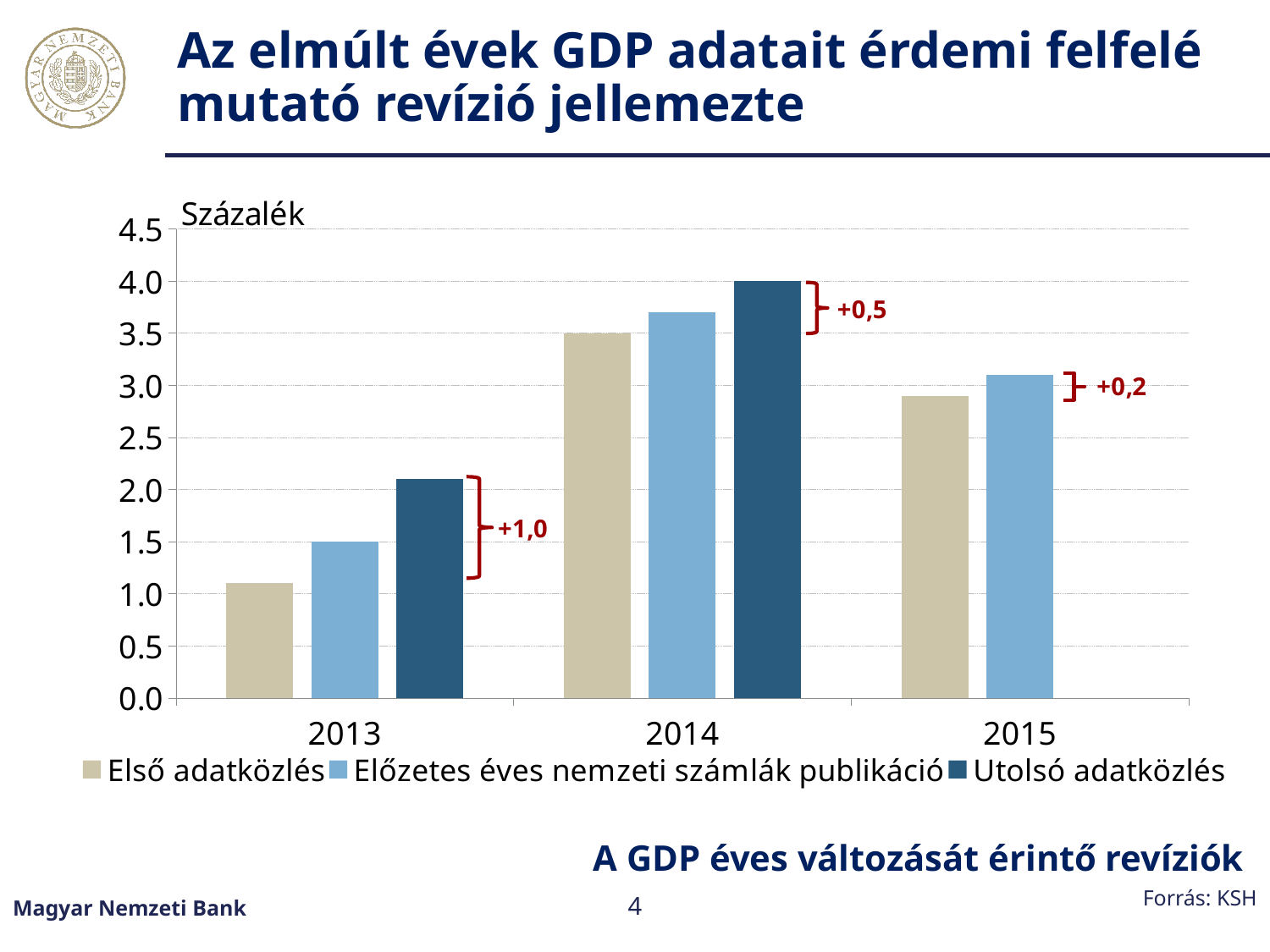
How many series does the legend list? 3 What revision is annotated next to the 2015 bars? +0,2 Which is larger: Első adatközlés for 2014 or Első adatközlés for 2015? Első adatközlés for 2014 Is the value of Első adatközlés for 2015 greater or less than 3.0? less What kind of chart is shown on the slide? bar chart What is the value of Utolsó adatközlés for 2014? 4.0 Which year has the highest Utolsó adatközlés value? 2014 Which bar is the lowest in the chart? Első adatközlés for 2013 How many years are shown on the x axis? 3 What revision is annotated next to the 2013 bars? +1,0 What is the value of Előzetes éves nemzeti számlák publikáció for 2013? 1.5 What is the value of Első adatközlés for 2014? 3.5